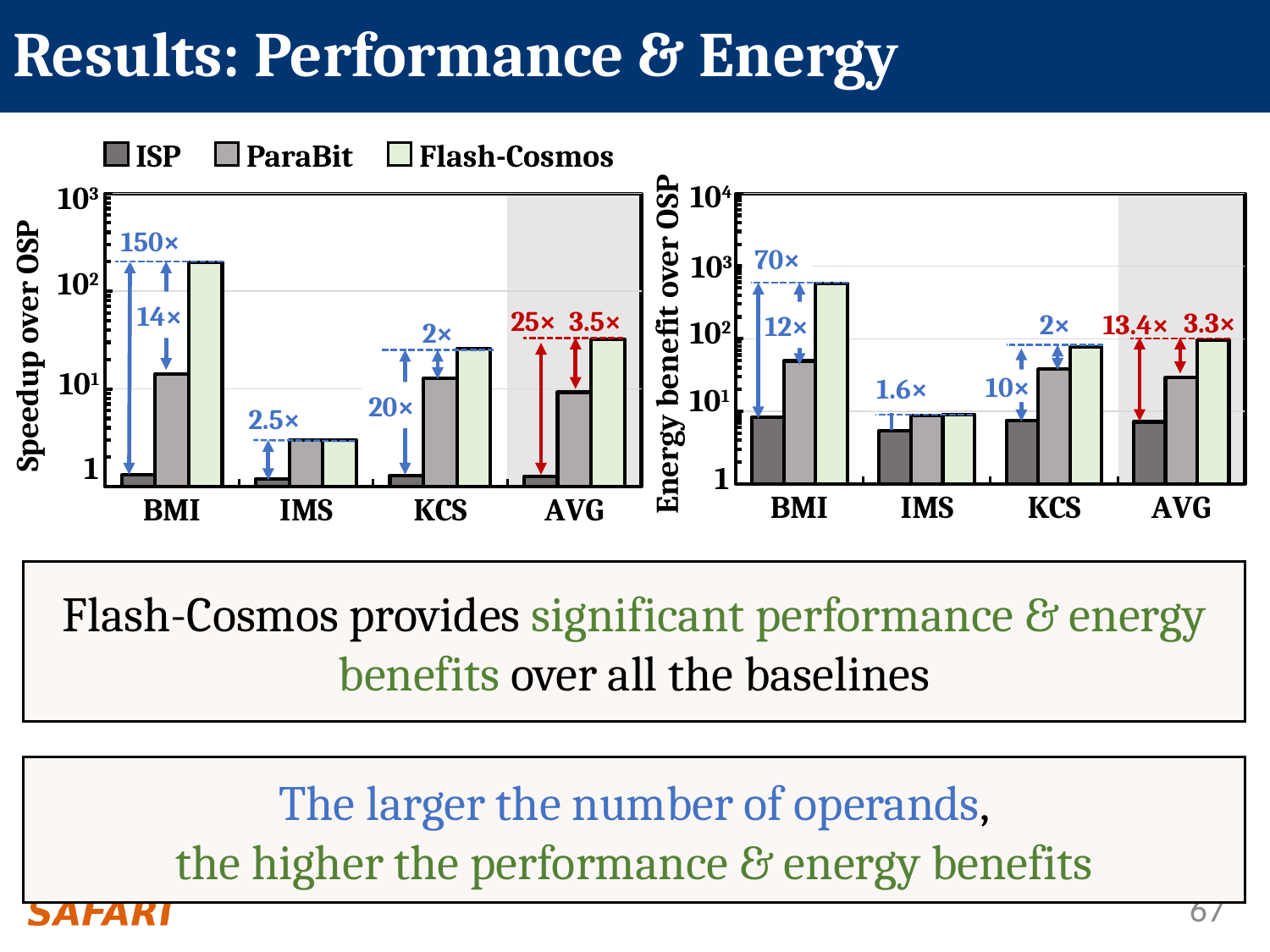
On the right chart (Energy benefit over OSP), what annotated energy benefit is shown for Flash-Cosmos over ISP in the AVG group? 13.4× On the left chart (Speedup over OSP), which is larger: the Flash-Cosmos bar for BMI or the Flash-Cosmos bar for KCS? BMI On the left chart (Speedup over OSP), what annotated speedup is shown for Flash-Cosmos over ISP in the BMI group? 150× On the left chart (Speedup over OSP), which category has the lowest Flash-Cosmos bar? IMS On the right chart (Energy benefit over OSP), which category has the highest Flash-Cosmos bar? BMI What kind of chart is the left chart (Speedup over OSP)? bar chart On the left chart (Speedup over OSP), is the Flash-Cosmos value for IMS greater or less than 10? less On the left chart (Speedup over OSP), is the Flash-Cosmos value for BMI greater or less than 100? greater How many series does the legend list? 3 On the right chart (Energy benefit over OSP), is the Flash-Cosmos value for KCS greater or less than 100? less On the left chart (Speedup over OSP), which category has the highest Flash-Cosmos bar? BMI How many categories are shown on the x axis of the right chart (Energy benefit over OSP)? 4